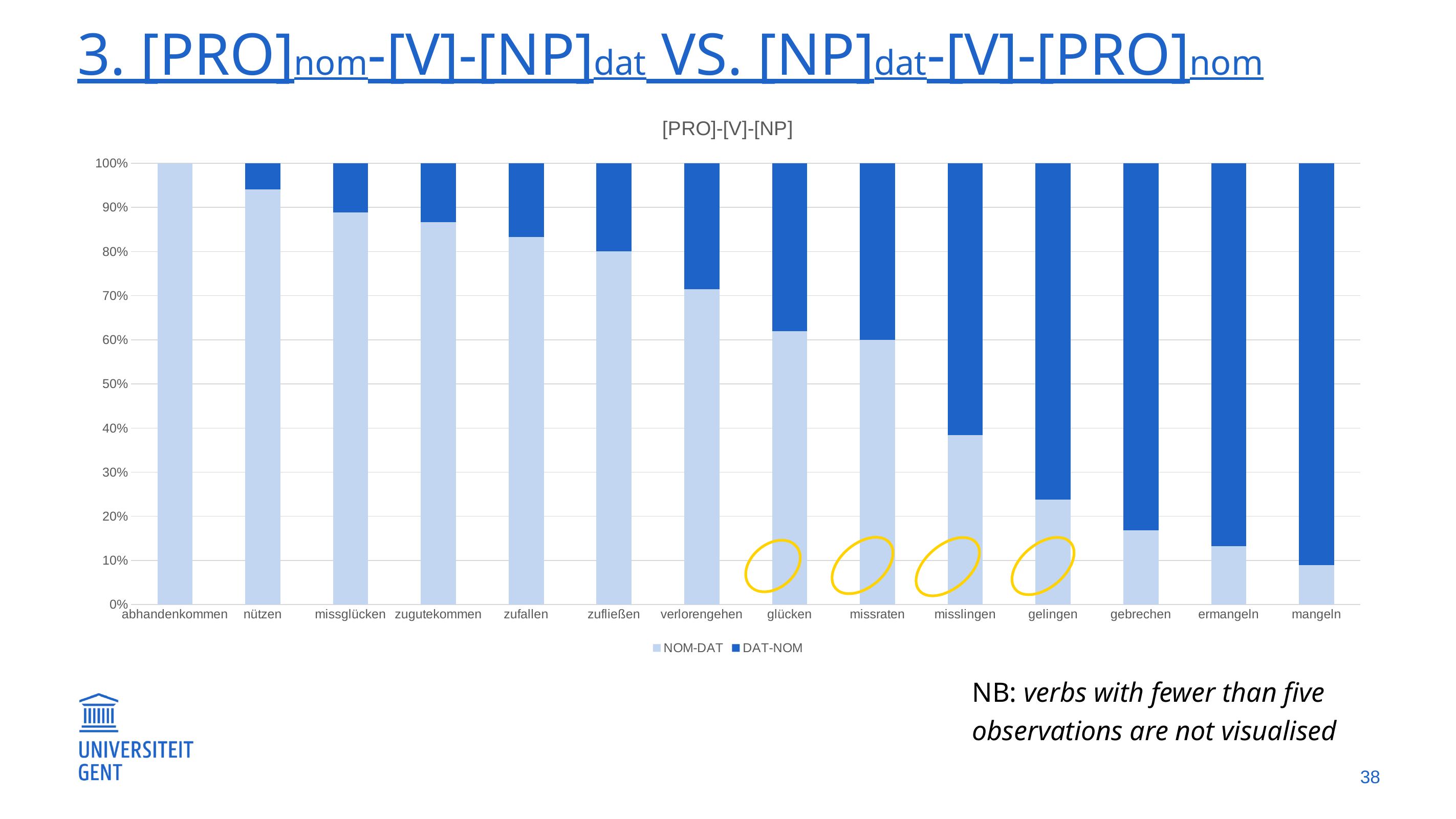
Which verb has the highest NOM-DAT share? abhandenkommen How many verbs are shown along the x axis of the chart? 14 Is the NOM-DAT share for zufallen greater or less than 80%? greater What is the title of the chart? [PRO]-[V]-[NP] Is the NOM-DAT share for gelingen greater or less than 30%? less How many series does the legend list? 2 What kind of chart is shown on the slide? stacked bar chart What is the NOM-DAT share for abhandenkommen? 100% Does the NOM-DAT share rise or fall moving from left to right along the x axis? fall Which verb has a larger NOM-DAT share, glücken or misslingen? glücken Is the NOM-DAT share for nützen greater or less than 90%? greater Which verb has the lowest NOM-DAT share? mangeln